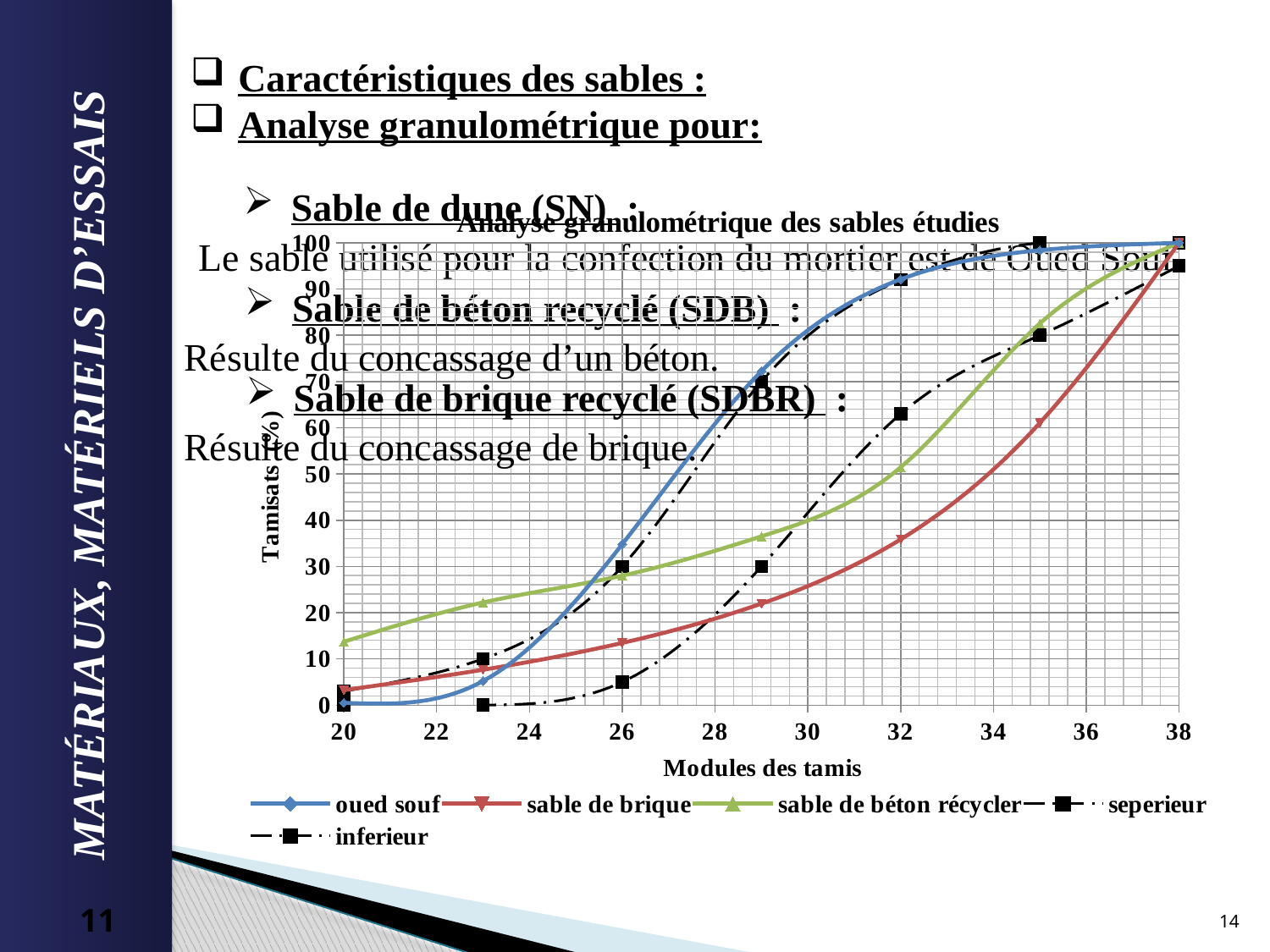
What is the title of the chart? Analyse granulométrique des sables étudies At module 20, which series has the highest value? sable de béton récycler Is the value for 'inferieur' at module 26 greater or less than 10? less Is the value for 'sable de béton récycler' at module 32 greater or less than 60? less Is the value for 'oued souf' at module 29 greater or less than 60? greater What kind of chart is shown on the slide? line chart Do the values of the 'sable de brique' series rise or fall as the module des tamis increases? rise How many data points are plotted for the 'oued souf' series? 7 At module 32, which series has the larger value: 'oued souf' or 'sable de brique'? oued souf What is the label of the x axis of the chart? Modules des tamis How many series does the legend of the chart list? 5